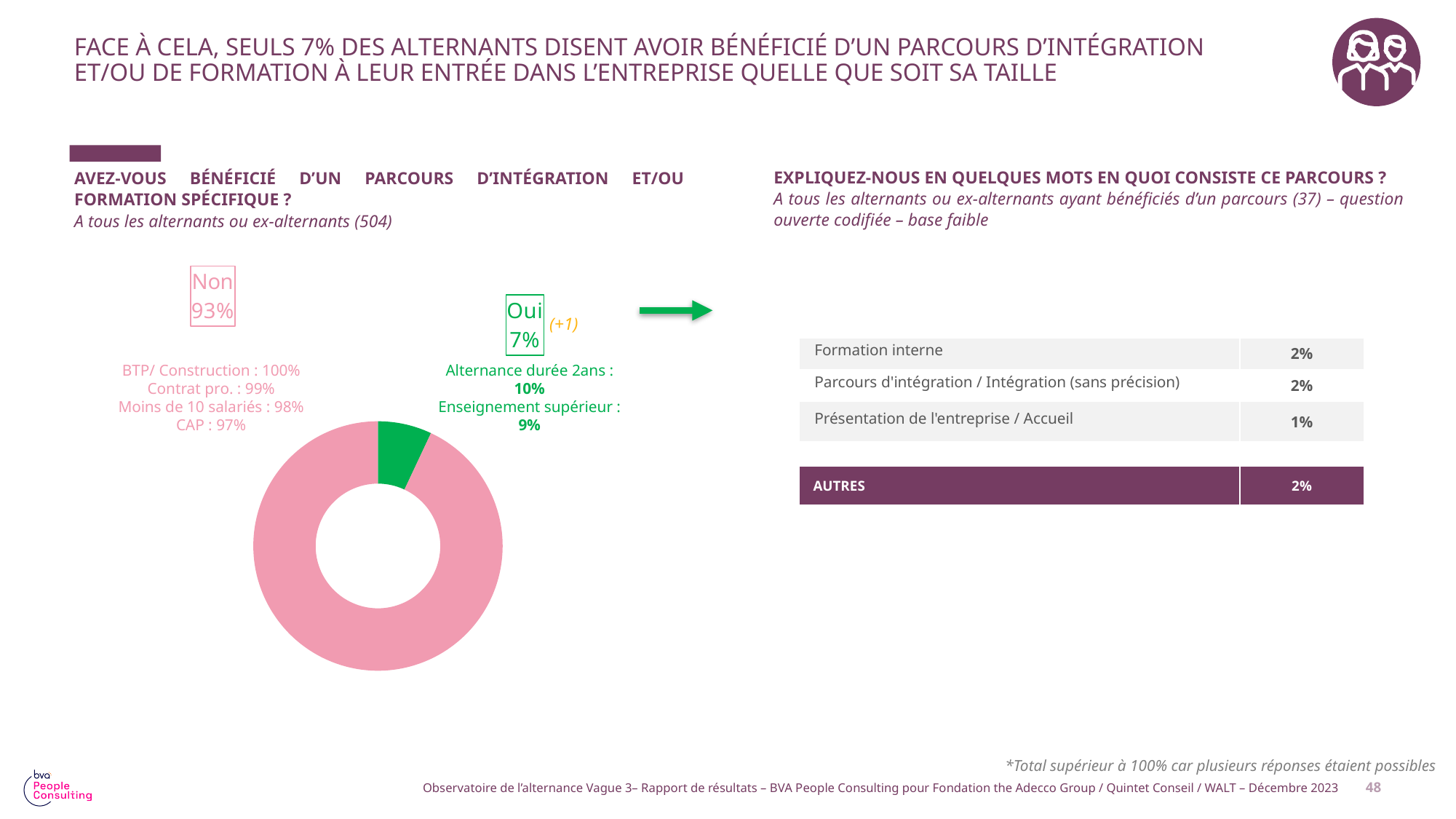
What kind of chart is used to show the Oui/Non split on the slide? pie chart (donut) What is the difference in percentage points between the "Non" and "Oui" shares in the donut chart? 86 percentage points What colour is the "Oui" slice in the donut chart? green In the donut chart, what percentage of respondents answered "Oui"? 7% What share of the donut chart does the "Oui" slice represent? 7% Which category has the largest share in the donut chart? Non What do the two slices of the donut chart add up to? 100% Which category has the smallest share in the donut chart? Oui In the donut chart, what percentage of respondents answered "Non"? 93% In the donut chart, which is larger: the share for "Oui" or the share for "Non"? Non What colour is the "Non" slice in the donut chart? pink How many categories does the donut chart show? 2